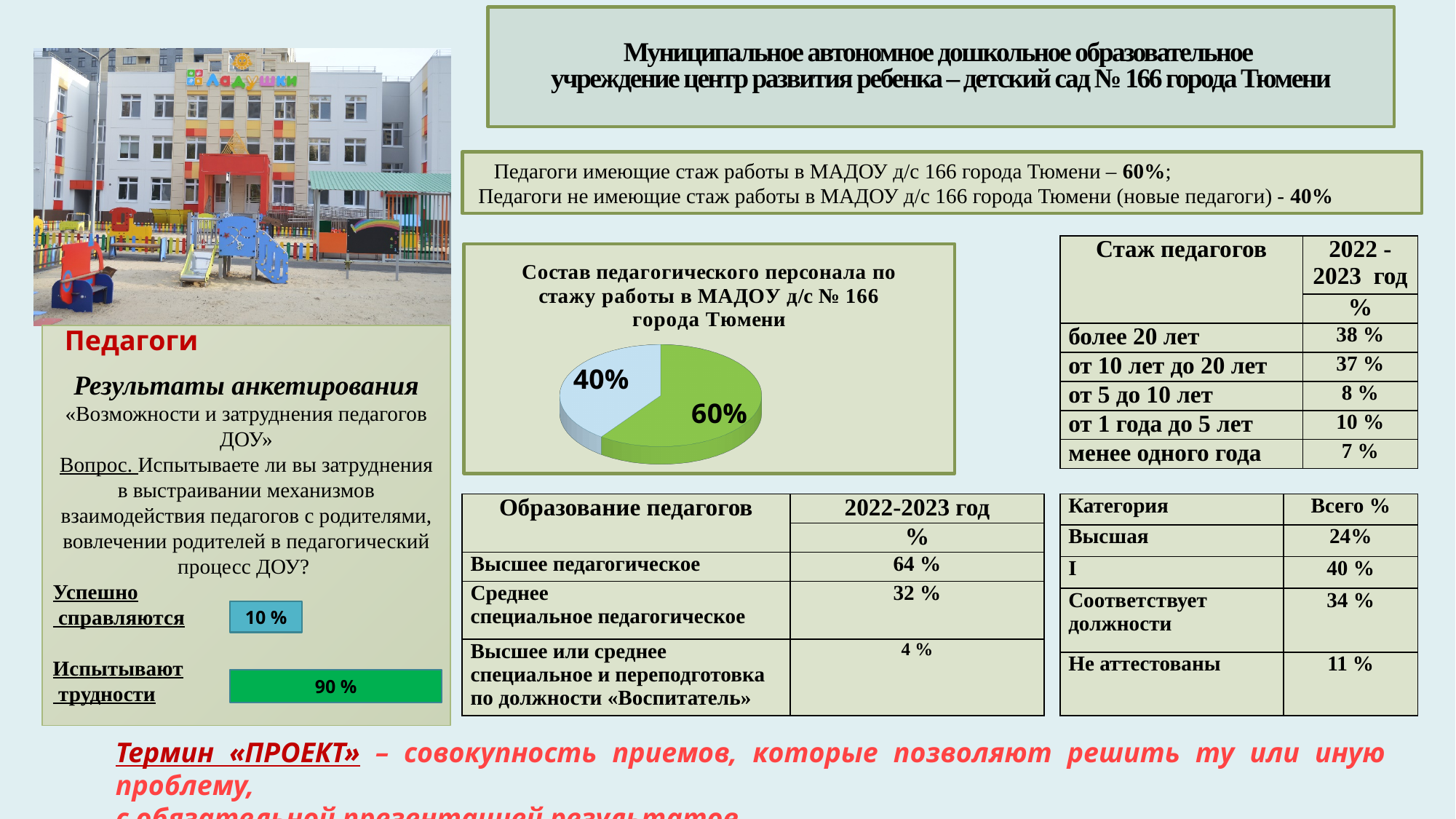
In the bars on the left of the slide under 'Результаты анкетирования', what is the value for 'Успешно справляются'? 10 % In the pie chart 'Состав педагогического персонала по стажу работы', what is the value of the smallest slice? 40% What kind of chart is shown under the title 'Состав педагогического персонала по стажу работы в МАДОУ д/с № 166 города Тюмени'? pie chart What colour is the 60% slice in the pie chart 'Состав педагогического персонала по стажу работы'? green In the bars on the left of the slide under 'Результаты анкетирования', what is the value for 'Испытывают трудности'? 90 % In the pie chart 'Состав педагогического персонала по стажу работы', what share does the green slice represent? 60% In the pie chart 'Состав педагогического персонала по стажу работы', what is the difference between the two slices? 20% In the pie chart 'Состав педагогического персонала по стажу работы', which slice is larger, the green one or the light blue one? the green one How many slices does the pie chart 'Состав педагогического персонала по стажу работы' have? 2 In the pie chart 'Состав педагогического персонала по стажу работы', is the value of the green slice greater or less than 50%? greater In the pie chart 'Состав педагогического персонала по стажу работы', what value is labelled on the light blue slice? 40% In the pie chart 'Состав педагогического персонала по стажу работы', what is the value of the largest slice? 60%